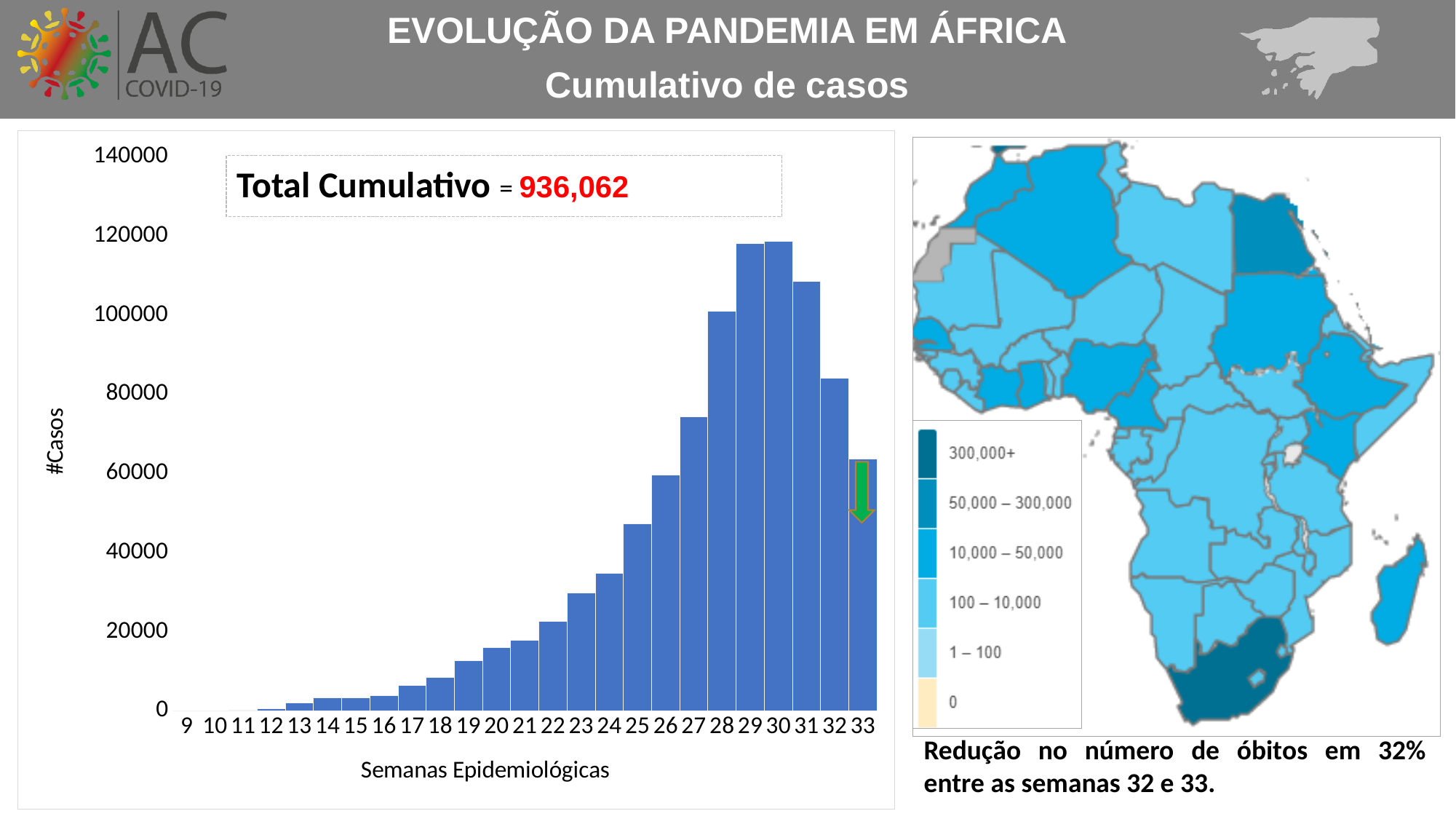
Which has more cases, week 31 or week 32? week 31 What total cumulative value is printed in the box above the bar chart? 936,062 Is the value for week 32 greater or less than 100000? less Is the value for week 20 greater or less than 20000? less Do the values rise or fall from week 30 to week 33? fall Is the value for week 25 greater or less than 40000? greater What kind of chart is shown on the left of the slide? bar chart How many epidemiological weeks are plotted on the x axis of the bar chart? 25 Which has more cases, week 32 or week 33? week 32 What is the label of the x axis of the bar chart? Semanas Epidemiológicas